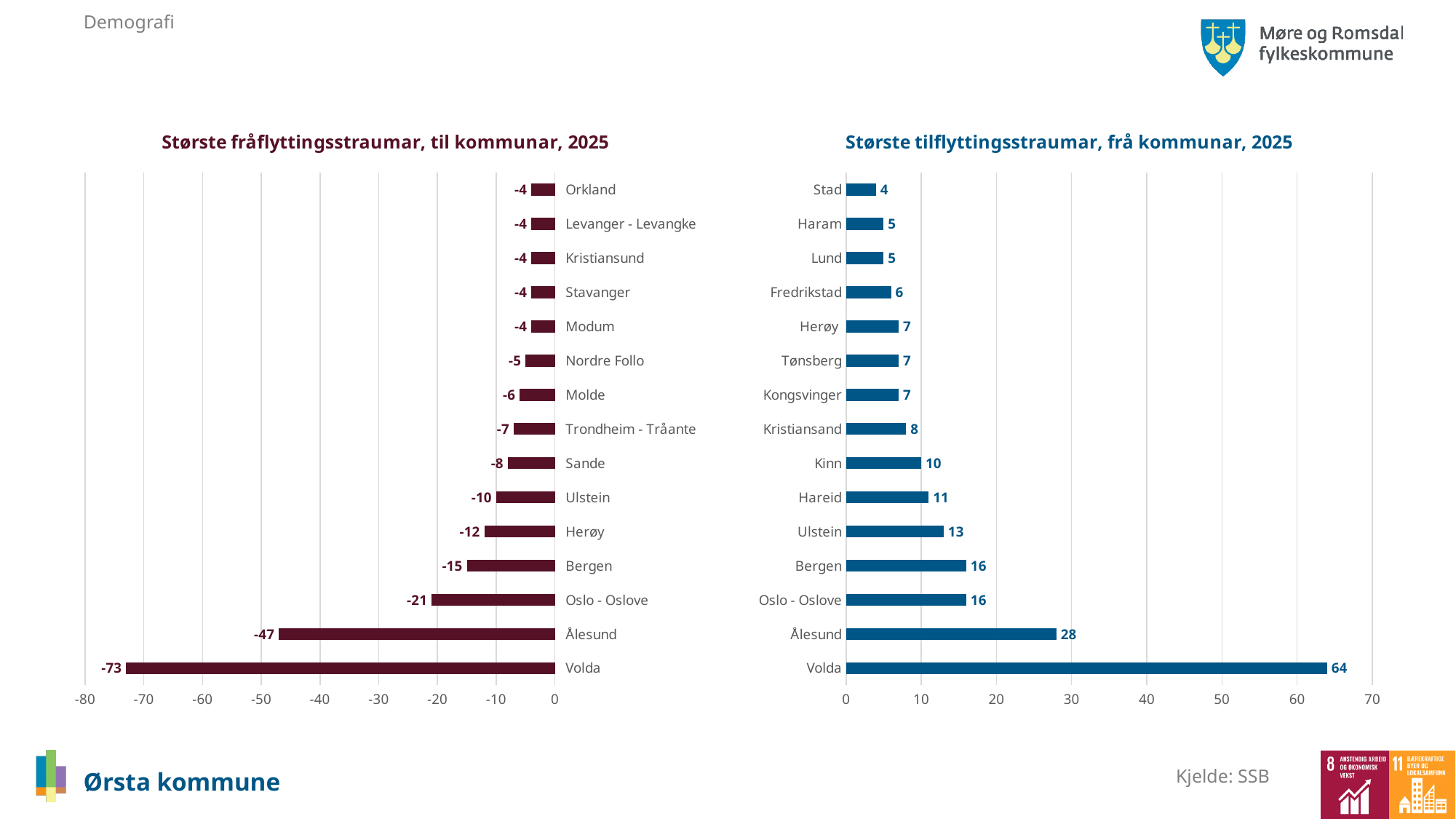
In the chart 'Største fråflyttingsstraumar, til kommunar, 2025', which municipality has the largest outflow (most negative value)? Volda In the chart 'Største tilflyttingsstraumar, frå kommunar, 2025', which municipality has the highest value? Volda What kind of chart is 'Største tilflyttingsstraumar, frå kommunar, 2025'? Bar chart In the chart 'Største tilflyttingsstraumar, frå kommunar, 2025', what is the value for Hareid? 11 In the chart 'Største fråflyttingsstraumar, til kommunar, 2025', what is the value for Ålesund? -47 In the chart 'Største tilflyttingsstraumar, frå kommunar, 2025', what is the difference between the values for Volda and Ålesund? 36 In the chart 'Største tilflyttingsstraumar, frå kommunar, 2025', which municipality has the lowest value? Stad What is the source cited at the bottom of the slide? Kjelde: SSB In the chart 'Største tilflyttingsstraumar, frå kommunar, 2025', which is larger, the value for Ulstein or the value for Kinn? Ulstein In the chart 'Største fråflyttingsstraumar, til kommunar, 2025', what is the difference between the values for Bergen and Herøy? 3 In the chart 'Største fråflyttingsstraumar, til kommunar, 2025', what is the value for Oslo - Oslove? -21 How many municipalities are shown in the chart 'Største fråflyttingsstraumar, til kommunar, 2025'? 15